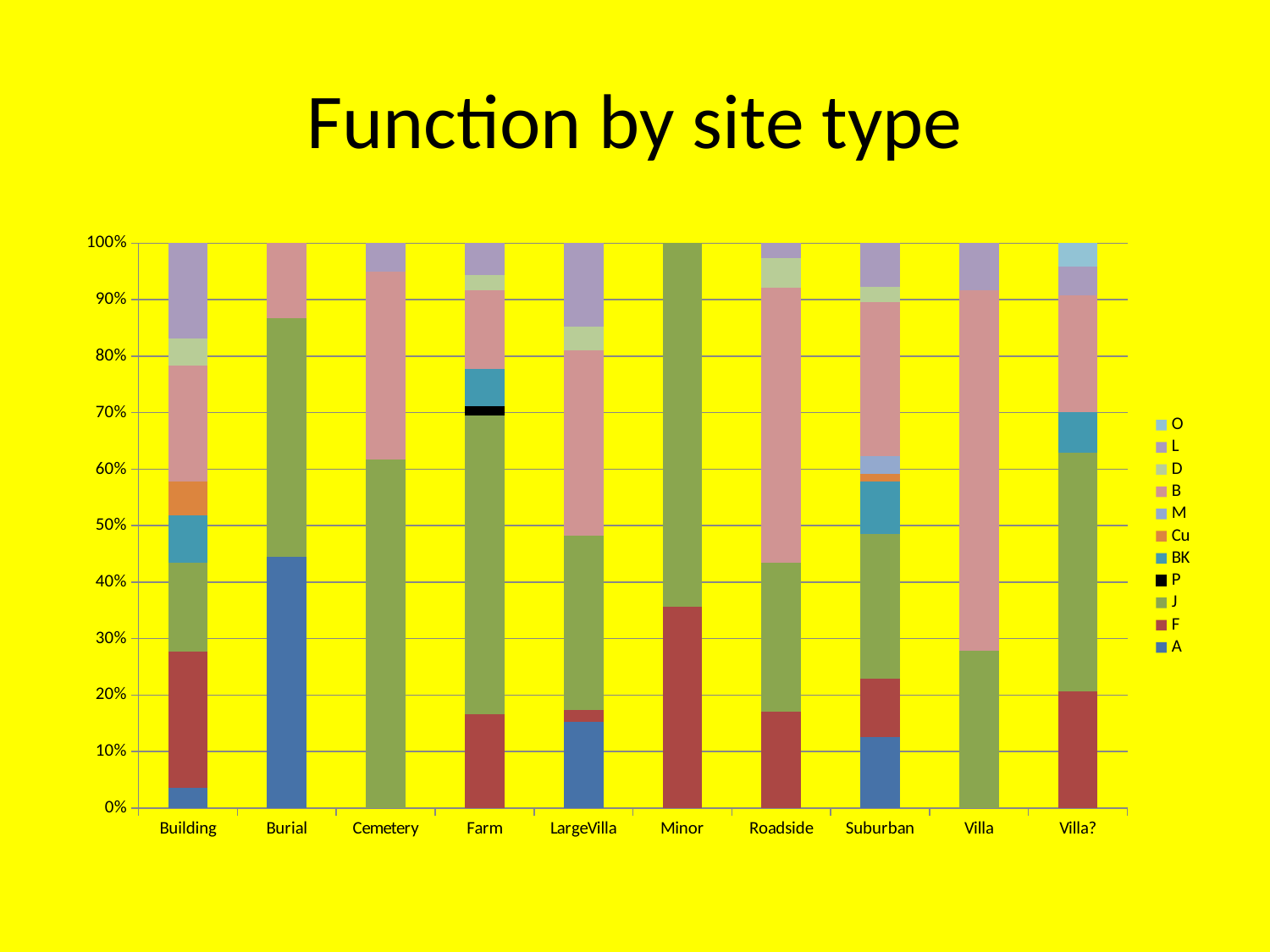
Is the A share for Building greater or less than 10%? less Which category has the larger A (blue) share, Burial or Building? Burial Is the F share for Minor greater or less than 30%? greater How many series does the legend list? 11 Which category has the larger B (pink) share, Villa or Burial? Villa What kind of chart is shown on the slide? stacked bar chart How many site type categories are shown on the x axis? 10 Is the J share for Villa greater or less than 30%? less Which category's bar is made up of only the J and F series? Minor What is the title of the chart? Function by site type Which category has the largest F (red) share? Minor